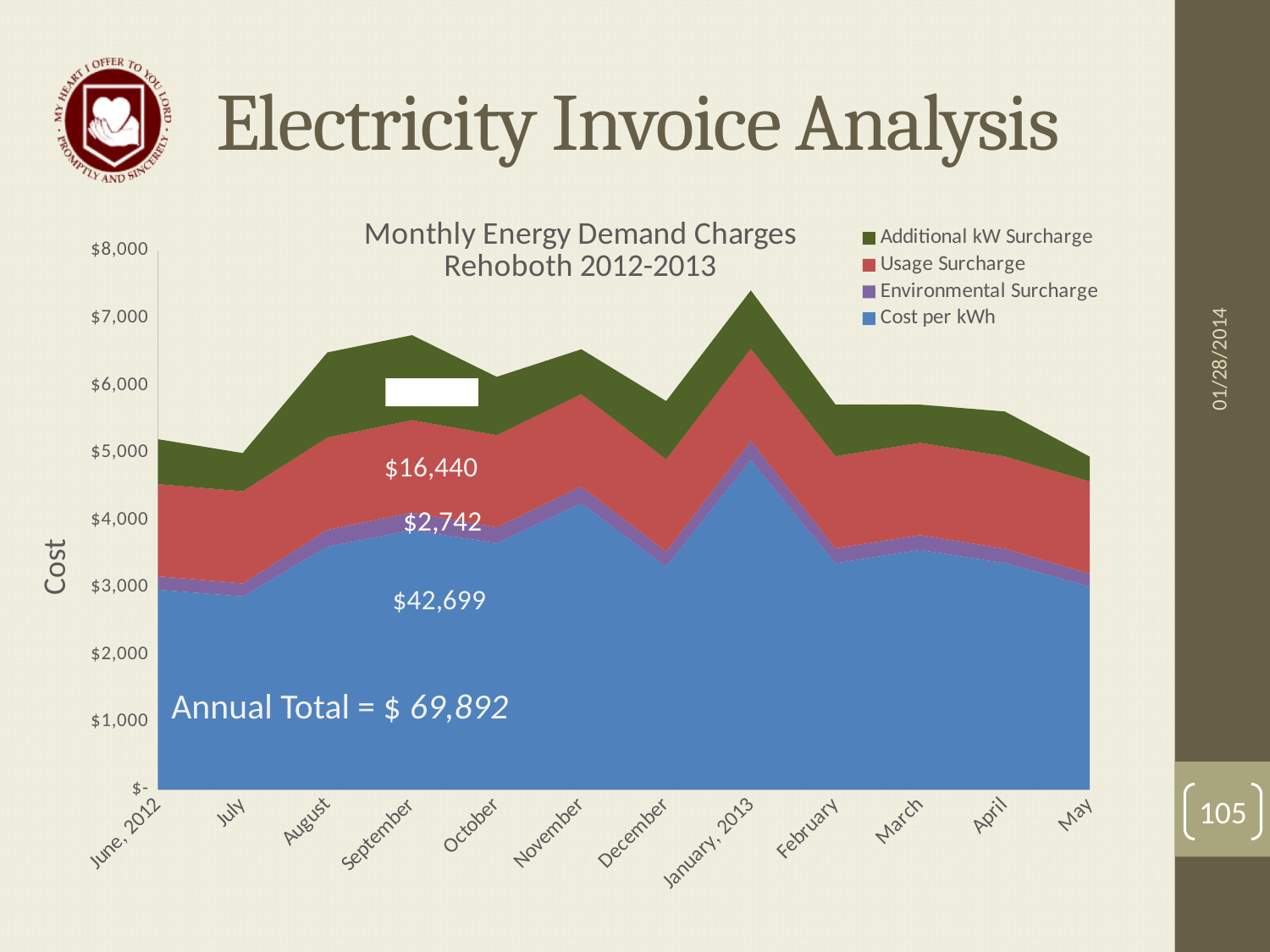
Is the total stacked charge for January, 2013 greater or less than $7,000? greater In which month is the total stacked monthly charge highest? January, 2013 What annual figure is printed inside the Cost per kWh (blue) area? $42,699 What annual total is printed on the chart? $ 69,892 How many months are shown along the x axis? 12 Is the total stacked charge for June, 2012 greater or less than $6,000? less Is the Cost per kWh value for December greater or less than $4,000? less How many series does the chart legend list? 4 Which series is shown at the bottom of the stack in blue? Cost per kWh From January, 2013 to May, does the total stacked charge rise or fall? fall What is the title of the chart? Monthly Energy Demand Charges Rehoboth 2012-2013 What type of chart is shown on the slide? Stacked area chart